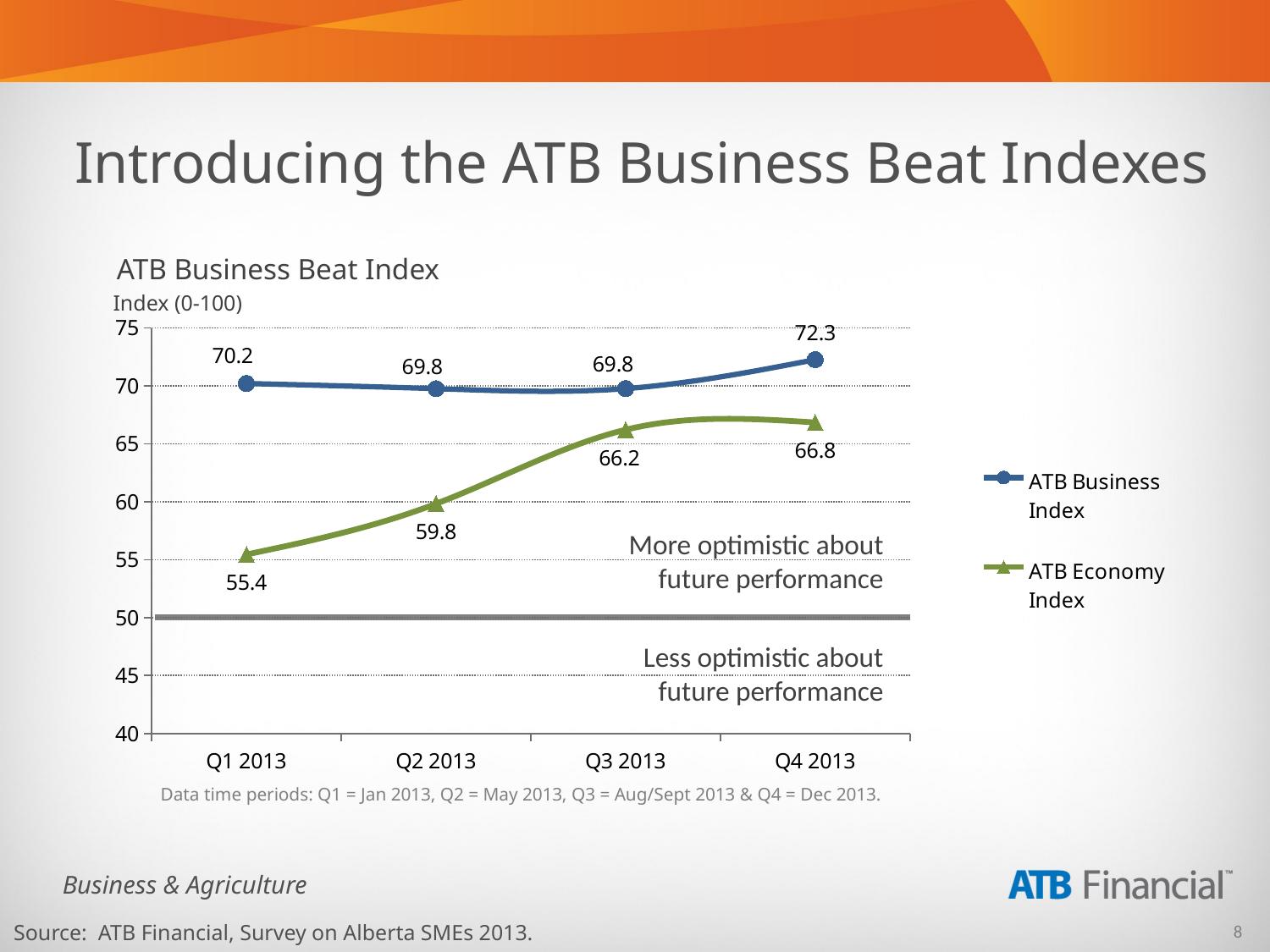
How many series does the legend list? 2 Which is larger in Q2 2013, the ATB Business Index or the ATB Economy Index? ATB Business Index In which quarter is the ATB Economy Index lowest? Q1 2013 What is the ATB Economy Index value for Q3 2013? 66.2 What is the ATB Economy Index value for Q1 2013? 55.4 How many quarters are plotted on the x axis? 4 What is the ATB Business Index value for Q4 2013? 72.3 What is the difference between the ATB Business Index and the ATB Economy Index in Q1 2013? 14.8 By how much did the ATB Economy Index rise from Q1 2013 to Q4 2013? 11.4 Is the ATB Economy Index value for Q2 2013 greater or less than 50? greater What kind of chart is shown on the slide? Line chart In which quarter is the ATB Business Index highest? Q4 2013